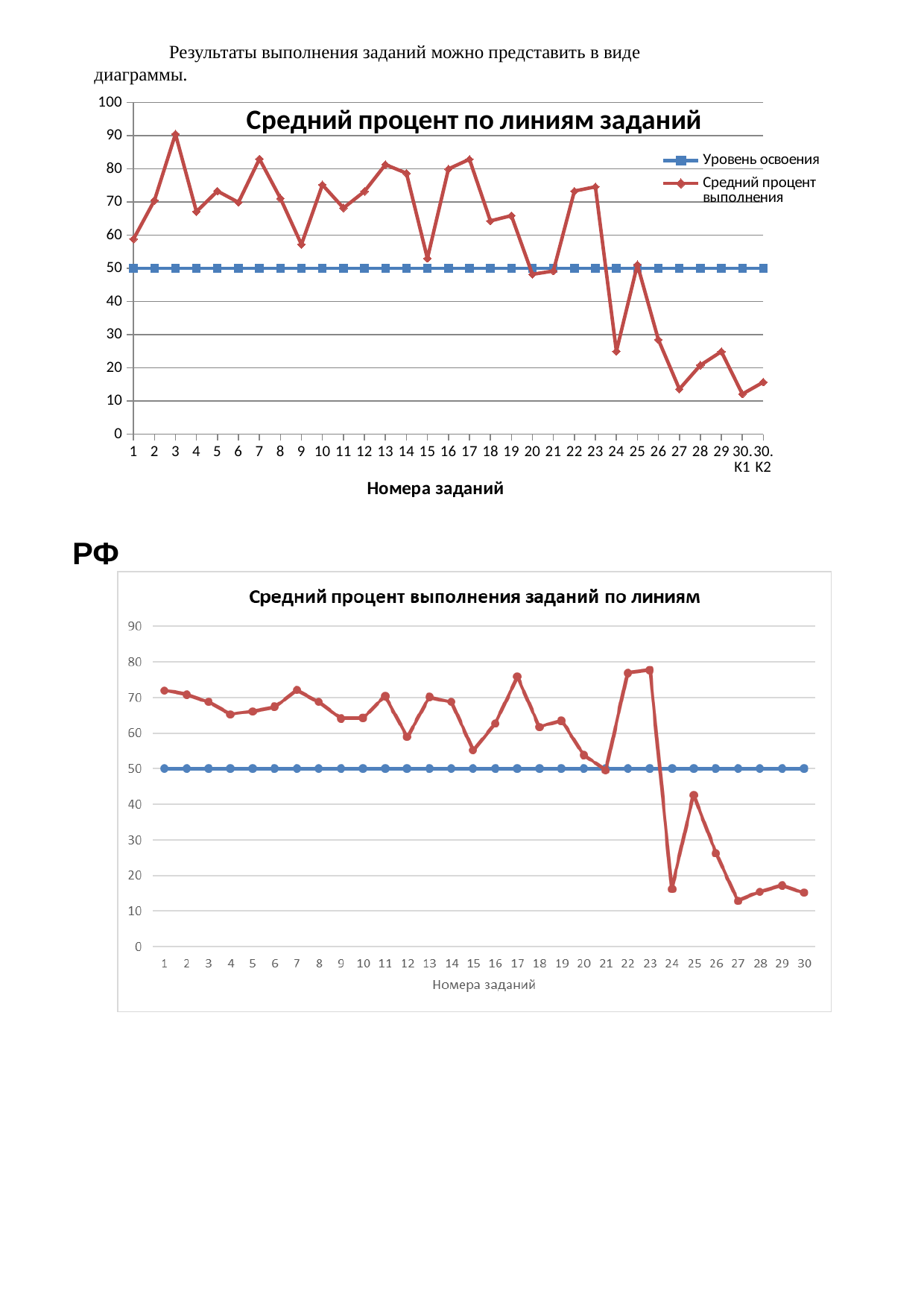
In the top chart "Средний процент по линиям заданий", how many series does the legend list? 2 In the top chart "Средний процент по линиям заданий", which task number has the highest average completion percentage? 3 In the top chart "Средний процент по линиям заданий", is the value for task 24 greater or less than 30? less In the bottom chart "Средний процент выполнения заданий по линиям", is the value for task 24 greater or less than 20? less What is the x-axis title of the top chart "Средний процент по линиям заданий"? Номера заданий In the bottom chart "Средний процент выполнения заданий по линиям", how many task numbers are shown on the x axis? 30 What kind of chart is the top chart titled "Средний процент по линиям заданий"? line chart In the top chart "Средний процент по линиям заданий", is the value for task 9 greater or less than 50? greater In the bottom chart "Средний процент выполнения заданий по линиям", which is larger: the value for task 1 or the value for task 27? task 1 In the top chart "Средний процент по линиям заданий", what is the value of the "Уровень освоения" line? 50 In the top chart "Средний процент по линиям заданий", which is larger: the value for task 7 or the value for task 26? task 7